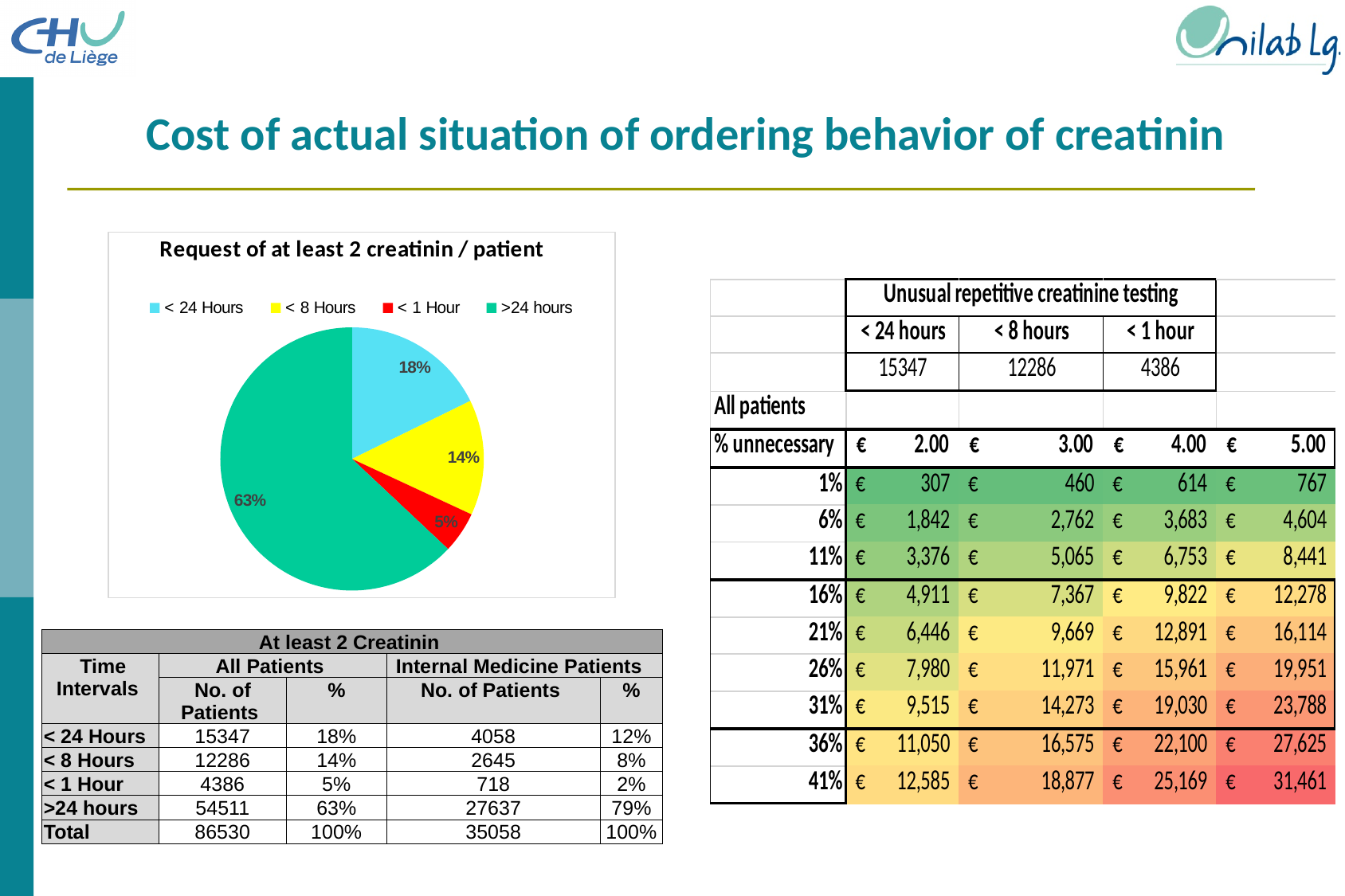
What is the difference in percentage points between the '>24 hours' slice and the '< 24 Hours' slice? 45 How many entries does the pie chart's legend list? 4 Which category has the smallest slice in the pie chart? < 1 Hour How many slices does the pie chart have? 4 What kind of chart is shown on the slide? pie chart What share of the pie does the '>24 hours' slice represent? 63% Which slice is larger in the pie chart, '< 24 Hours' or '< 8 Hours'? < 24 Hours What share of the pie does the '< 24 Hours' slice represent? 18% What share of the pie does the '< 8 Hours' slice represent? 14% Which category has the largest slice in the pie chart? >24 hours What is the title of the pie chart? Request of at least 2 creatinin / patient